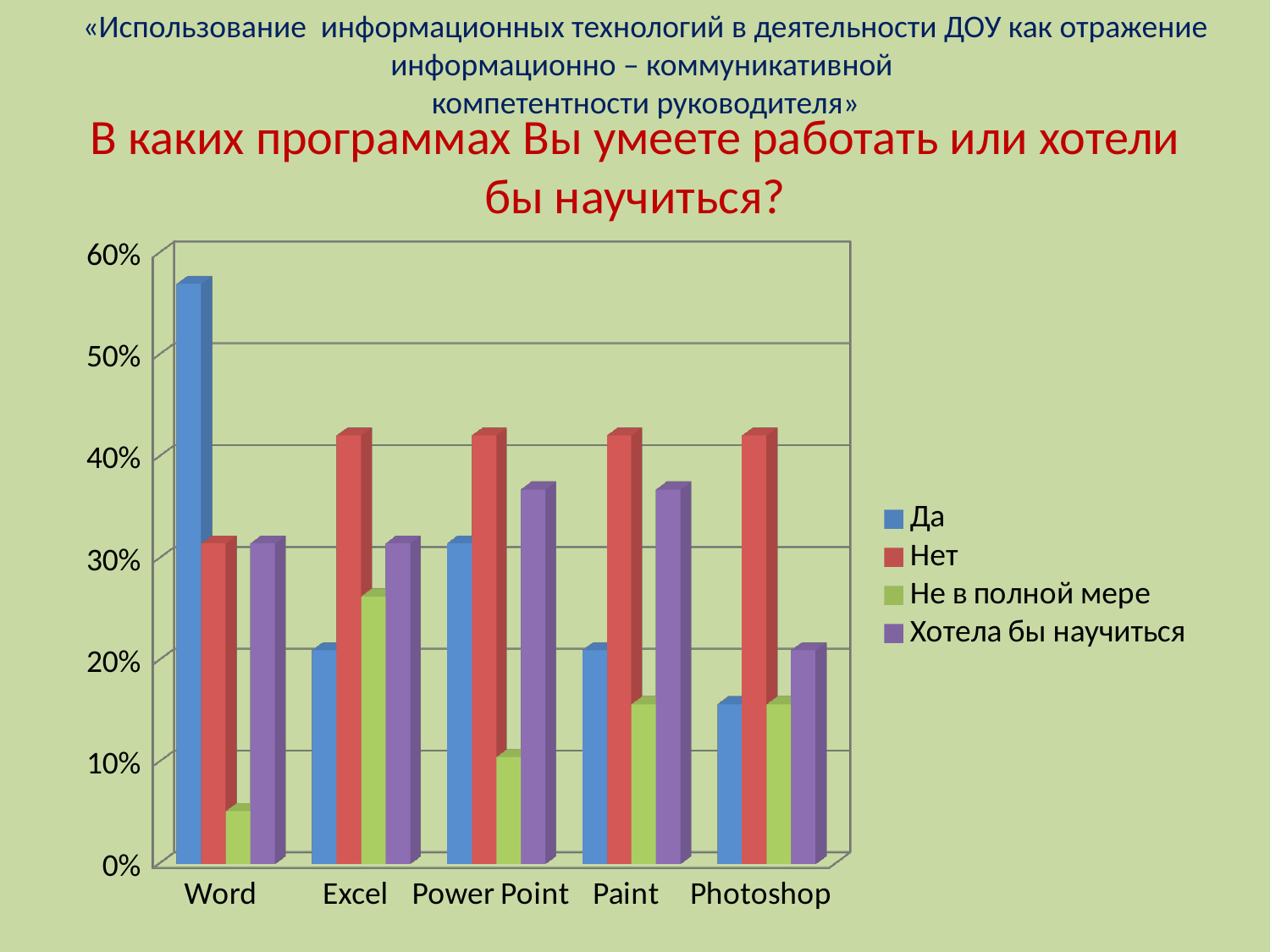
How many programs (categories) are shown on the x axis of the chart? 5 How many series does the chart legend list? 4 Is the "Да" value for Word greater or less than 50%? greater Which series is shown in purple in the chart legend? Хотела бы научиться Which program has the highest value for the "Да" series? Word What kind of chart is shown on the slide? bar chart Is the "Нет" value for Photoshop greater or less than 40%? greater Is the "Не в полной мере" value for Word greater or less than 10%? less For Excel, which is larger: the "Да" value or the "Нет" value? Нет Which program has the lowest value for the "Хотела бы научиться" series? Photoshop Which program has the lowest value for the "Да" series? Photoshop Which program has the highest value for the "Не в полной мере" series? Excel